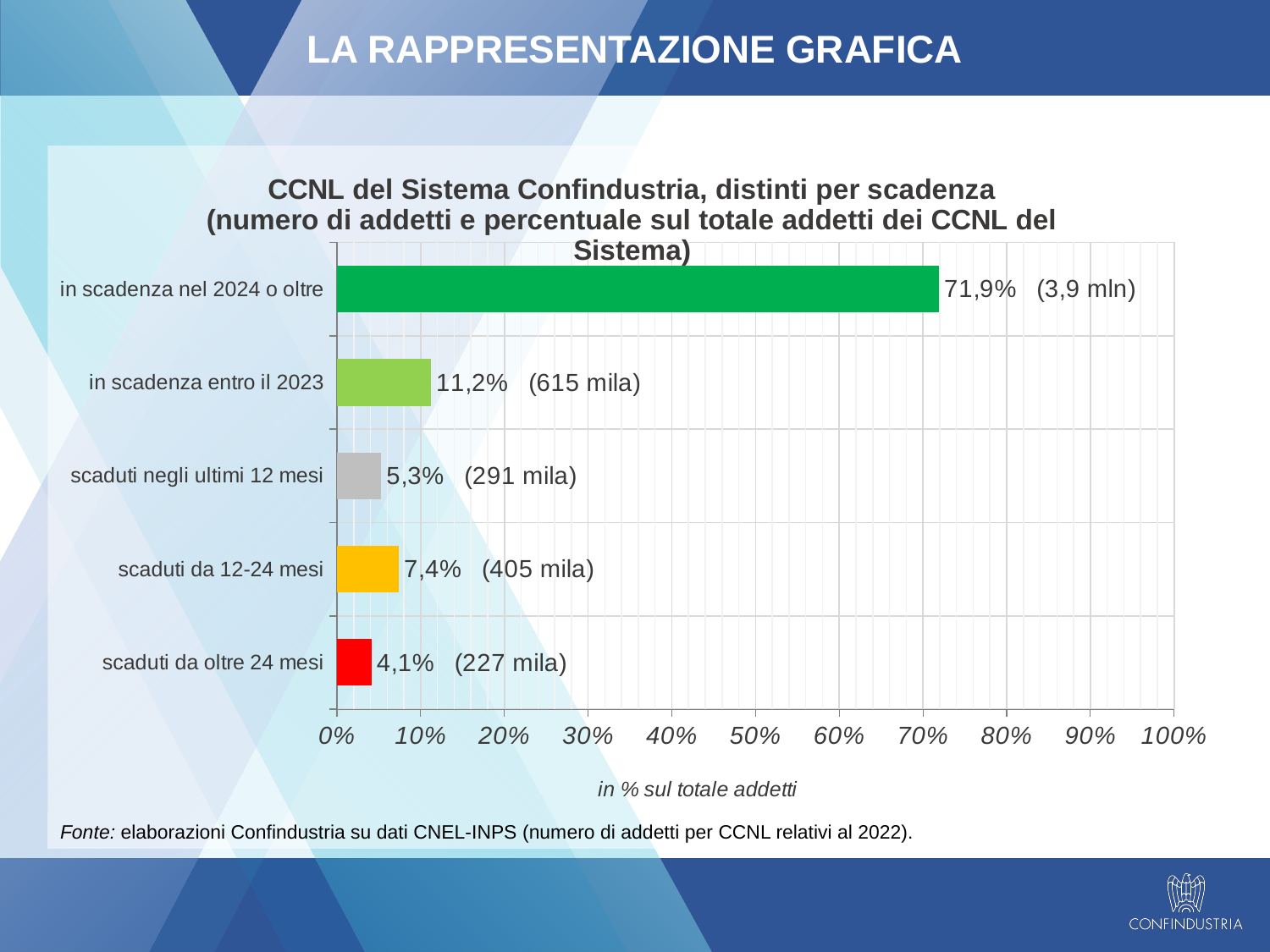
What is the difference in percentage points between 'in scadenza entro il 2023' and 'scaduti negli ultimi 12 mesi'? 5,9 How many addetti are indicated for 'in scadenza entro il 2023'? 615 mila How many categories are shown in the chart? 5 Which is larger: the percentage for 'scaduti da 12-24 mesi' or for 'scaduti negli ultimi 12 mesi'? scaduti da 12-24 mesi Which category has the highest percentage? in scadenza nel 2024 o oltre What percentage is shown for 'in scadenza nel 2024 o oltre'? 71,9% What colour is the bar for 'scaduti da oltre 24 mesi'? red What kind of chart is shown on the slide? bar chart Which category has the lowest percentage? scaduti da oltre 24 mesi What percentage is shown for 'scaduti da 12-24 mesi'? 7,4% What is the label shown below the x axis of the chart? in % sul totale addetti Is the value for 'in scadenza nel 2024 o oltre' greater or less than 70%? greater